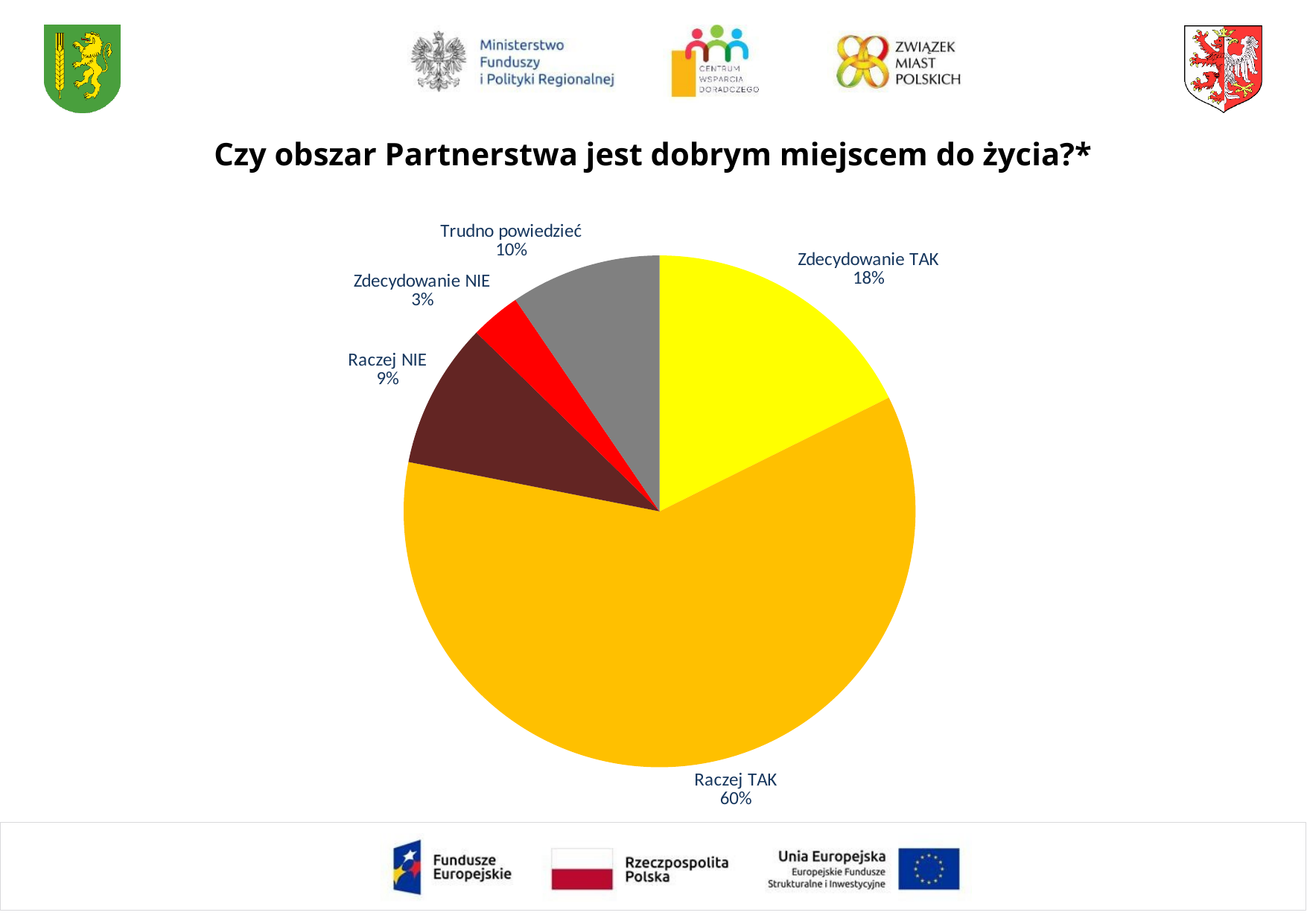
What share of responses is "Trudno powiedzieć"? 10% What share of responses is "Zdecydowanie TAK"? 18% What is the title of the chart? Czy obszar Partnerstwa jest dobrym miejscem do życia?* Which response category has the largest share of the pie? Raczej TAK What share of responses is "Raczej TAK"? 60% What is the combined share of "Raczej NIE" and "Zdecydowanie NIE"? 12% How many categories are shown in the pie chart? 5 What is the difference in percentage points between "Raczej TAK" and "Zdecydowanie TAK"? 42 What share of responses is "Zdecydowanie NIE"? 3% Which is larger, the share for "Raczej NIE" or the share for "Trudno powiedzieć"? Trudno powiedzieć Which response category has the smallest share of the pie? Zdecydowanie NIE What kind of chart is shown on the slide? Pie chart